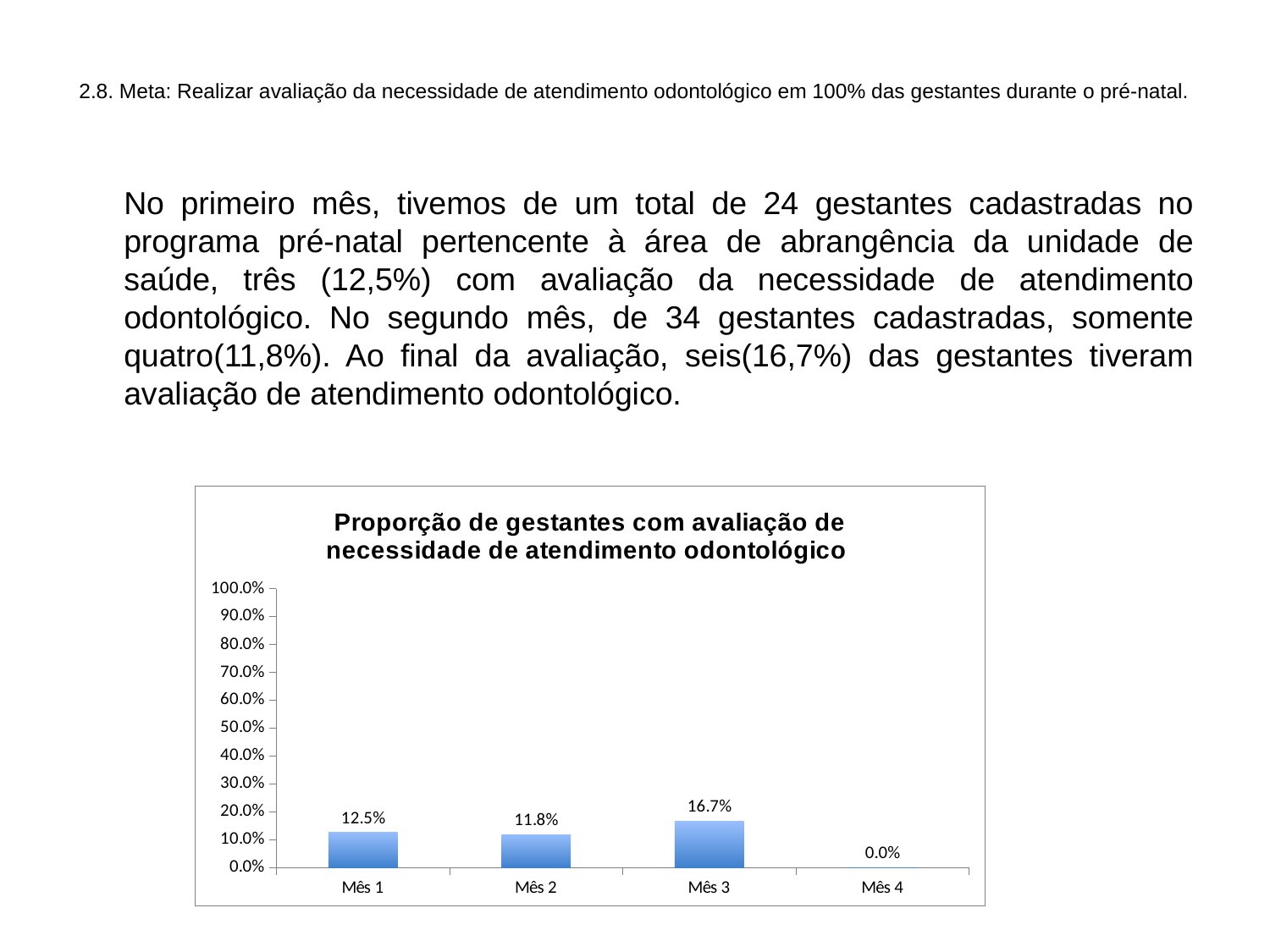
Which month has the lowest value? Mês 4 How many months are shown on the x axis? 4 What kind of chart is shown? bar chart What is the value for Mês 2? 11.8% What is the difference between the values for Mês 3 and Mês 1? 4.2% What is the value for Mês 4? 0.0% What is the value for Mês 3? 16.7% Is the value for Mês 3 greater or less than 50%? less Which month has the highest value? Mês 3 What is the value for Mês 1? 12.5% Which is larger, the value for Mês 1 or Mês 2? Mês 1 What is the title of the chart? Proporção de gestantes com avaliação de necessidade de atendimento odontológico